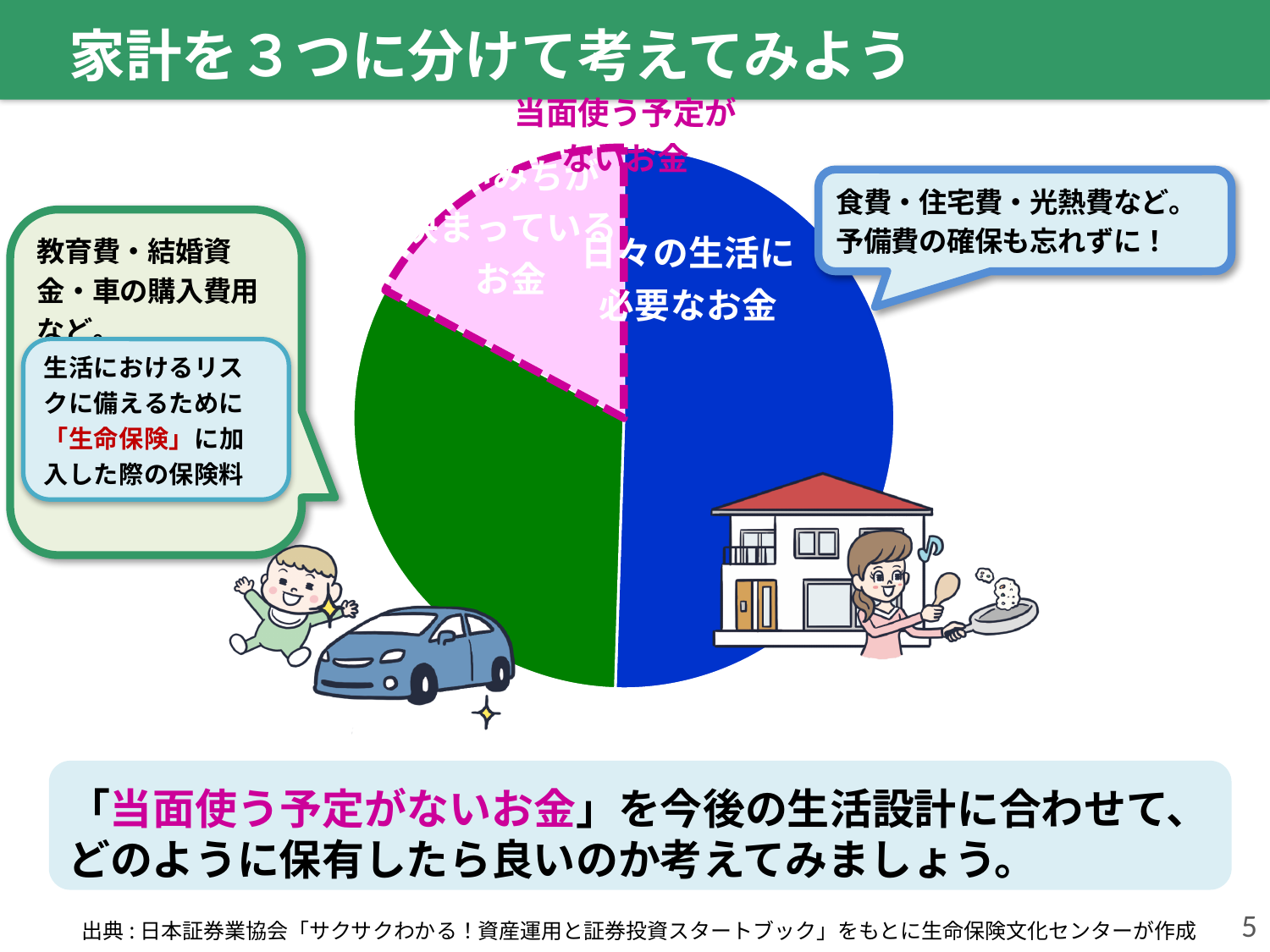
Which slice of the pie chart is the smallest? 当面使う予定がないお金 How many slices does the pie chart have? 3 Which is larger in the pie chart, 日々の生活に必要なお金 or 当面使う予定がないお金? 日々の生活に必要なお金 Which is larger in the pie chart, the green slice or the pink slice (当面使う予定がないお金)? the green slice What kind of chart is shown on the slide? pie chart Which slice of the pie chart is the largest? 日々の生活に必要なお金 What colour is the 当面使う予定がないお金 slice of the pie chart? pink What colour is the 日々の生活に必要なお金 slice of the pie chart? blue